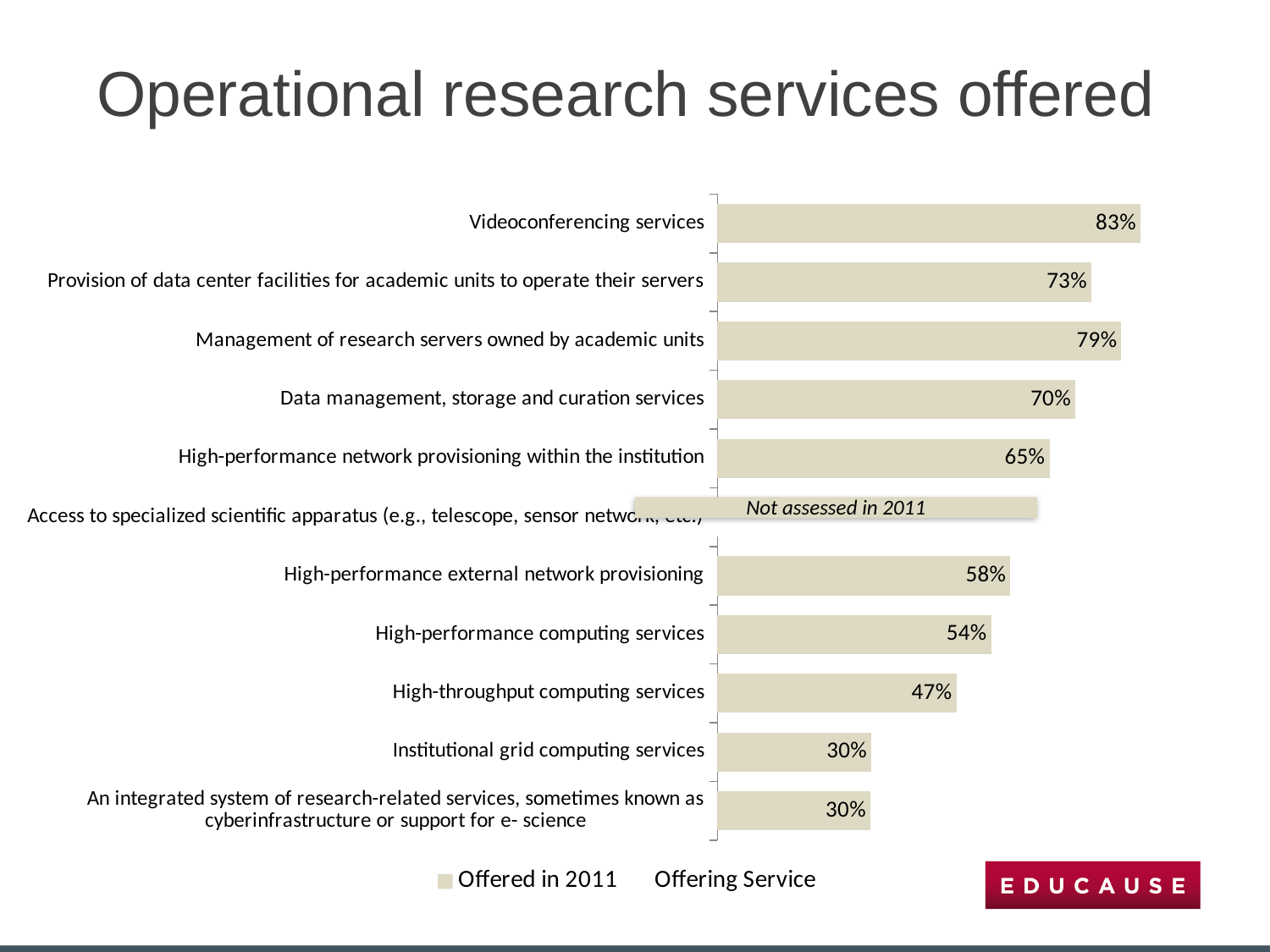
What percentage is shown for Videoconferencing services? 83% What kind of chart is shown on the slide? Bar chart How many service categories are listed on the chart's axis? 11 What value is shown for High-performance computing services? 54% What is the title of the slide? Operational research services offered What is the difference between the values for High-performance external network provisioning and High-throughput computing services? 11 percentage points Which is larger: the value for Management of research servers owned by academic units or the value for Provision of data center facilities for academic units to operate their servers? Management of research servers owned by academic units What is the difference between the values for Videoconferencing services and Provision of data center facilities for academic units to operate their servers? 10 percentage points Which service has the highest percentage in the chart? Videoconferencing services What note is shown in place of a bar for Access to specialized scientific apparatus? Not assessed in 2011 What percentage is shown for Institutional grid computing services? 30% What value is shown for Data management, storage and curation services? 70%